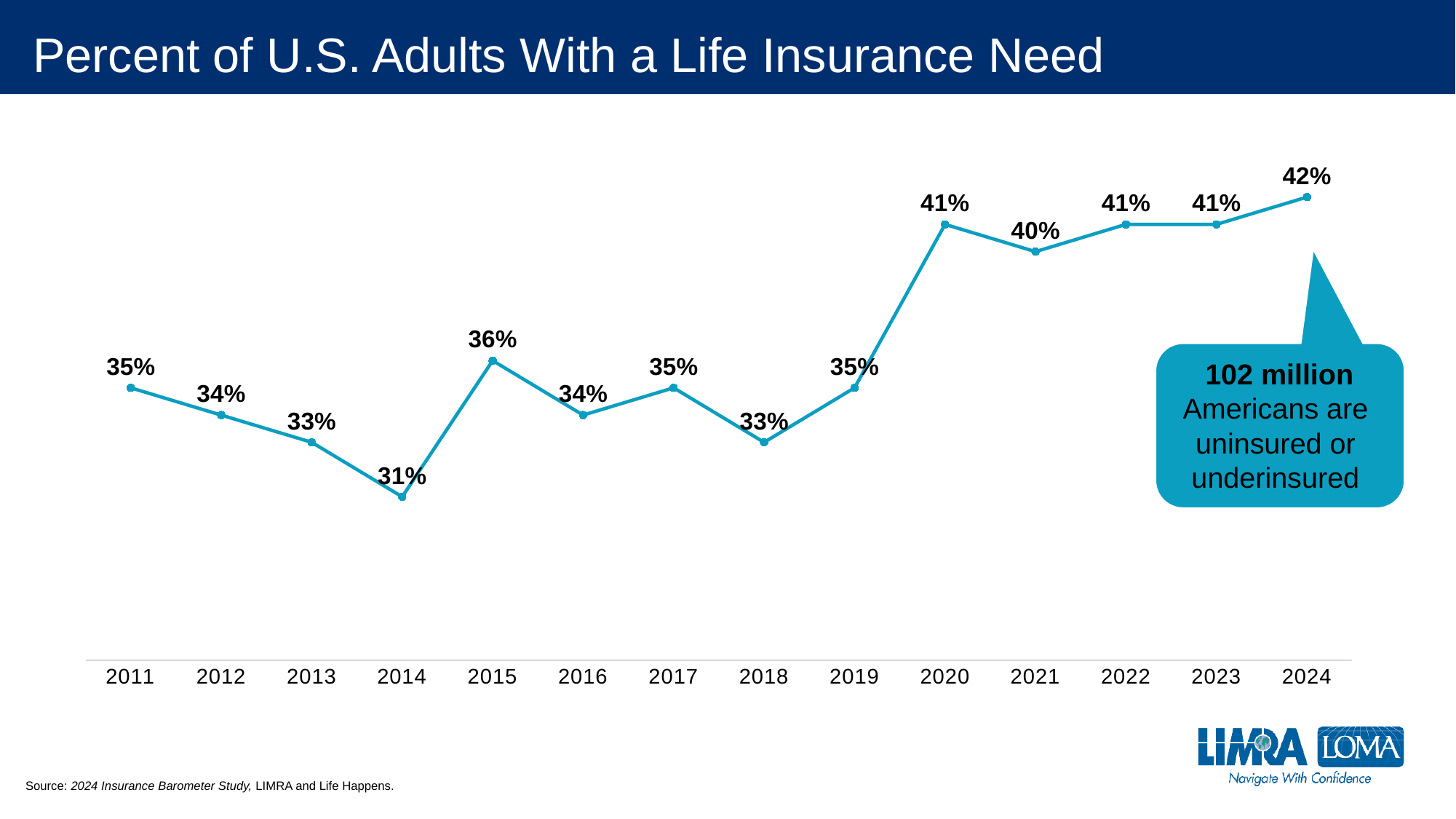
Which year has the lowest percent of U.S. adults with a life insurance need? 2014 Does the value rise or fall from 2011 to 2014? Fall What is the value shown for 2024? 42% Which year has a higher value, 2015 or 2018? 2015 What is the difference in percentage points between 2024 and 2014? 11 What percent of U.S. adults had a life insurance need in 2014? 31% How many years are plotted on the chart? 14 What is the difference in percentage points between 2020 and 2019? 6 Which year has the highest percent of U.S. adults with a life insurance need? 2024 What is the value shown for 2021? 40% What kind of chart is shown on the slide? Line chart According to the callout on the chart, how many Americans are uninsured or underinsured? 102 million